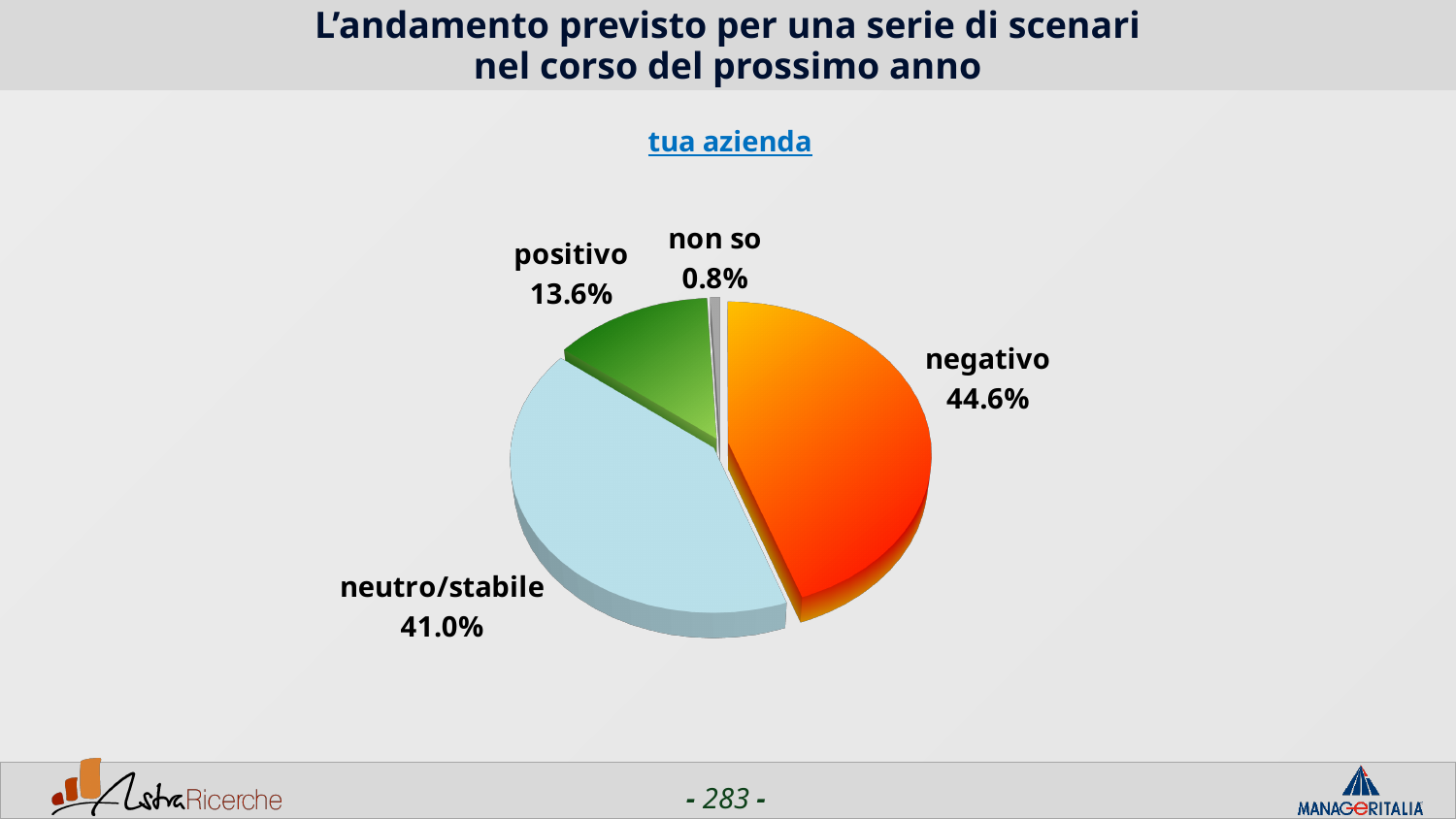
What is the difference between the values for "negativo" and "neutro/stabile"? 3.6% What is the value for "negativo"? 44.6% What is the subtitle shown above the pie chart? tua azienda How many slices does the pie chart have? 4 What is the value for "positivo"? 13.6% What kind of chart is shown on the slide? pie chart What is the value for "neutro/stabile"? 41.0% What is the value for "non so"? 0.8% Which category has the smallest share of the pie? non so Which is larger, the value for "positivo" or the value for "non so"? positivo Which category has the largest share of the pie? negativo What colour is the "positivo" slice? green